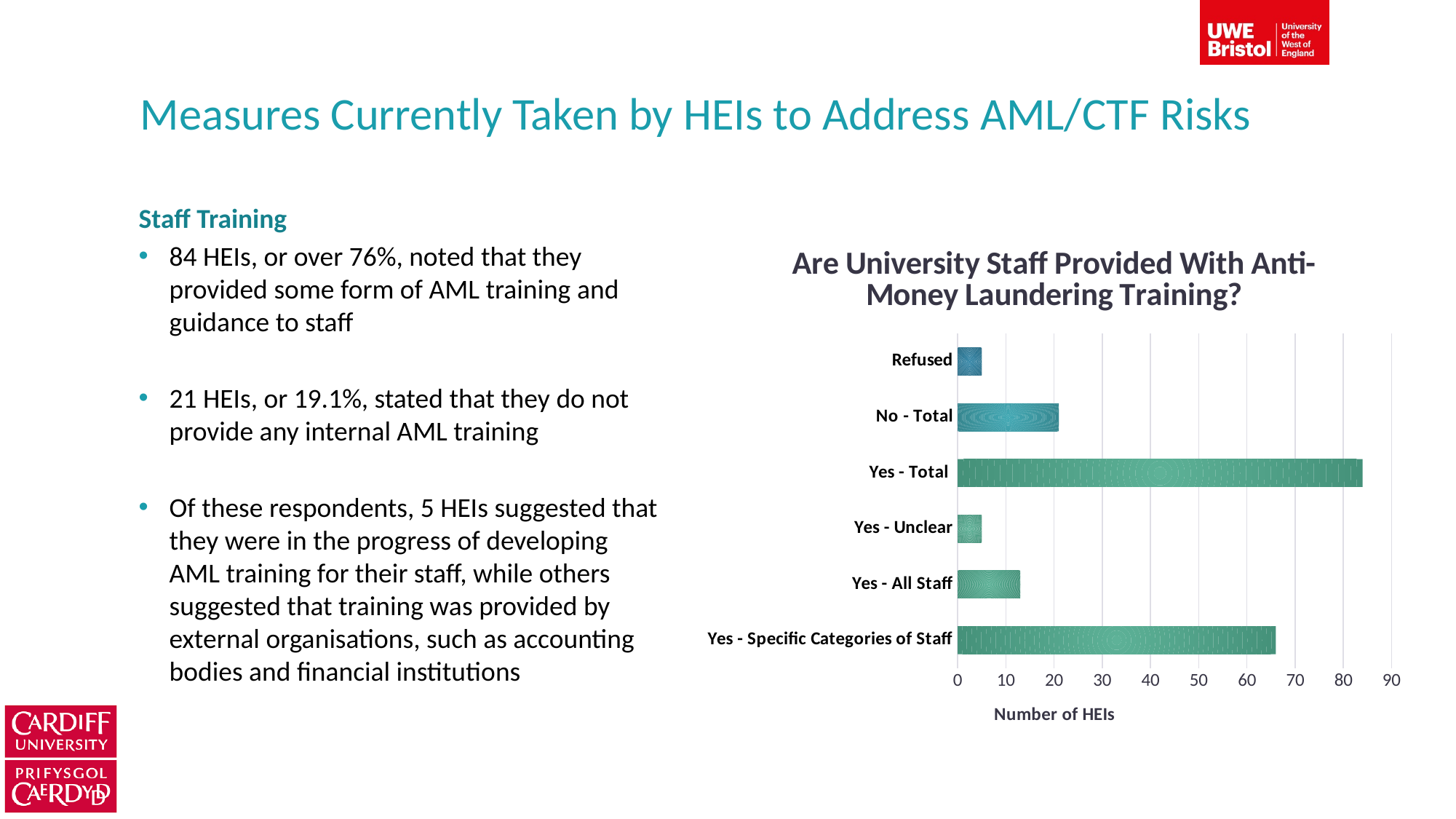
How many categories are shown in the chart? 6 What kind of chart is shown on the slide? bar chart What is the label of the horizontal axis of the chart? Number of HEIs Is the value for Yes - Total greater or less than 80? greater Is the value for Yes - Specific Categories of Staff greater or less than 60? greater What is the title of the chart? Are University Staff Provided With Anti-Money Laundering Training? Is the value for Refused greater or less than 10? less Which category has the highest number of HEIs? Yes - Total Which is larger, the value for No - Total or the value for Yes - All Staff? No - Total Which is larger, the value for Yes - Specific Categories of Staff or the value for Yes - Total? Yes - Total